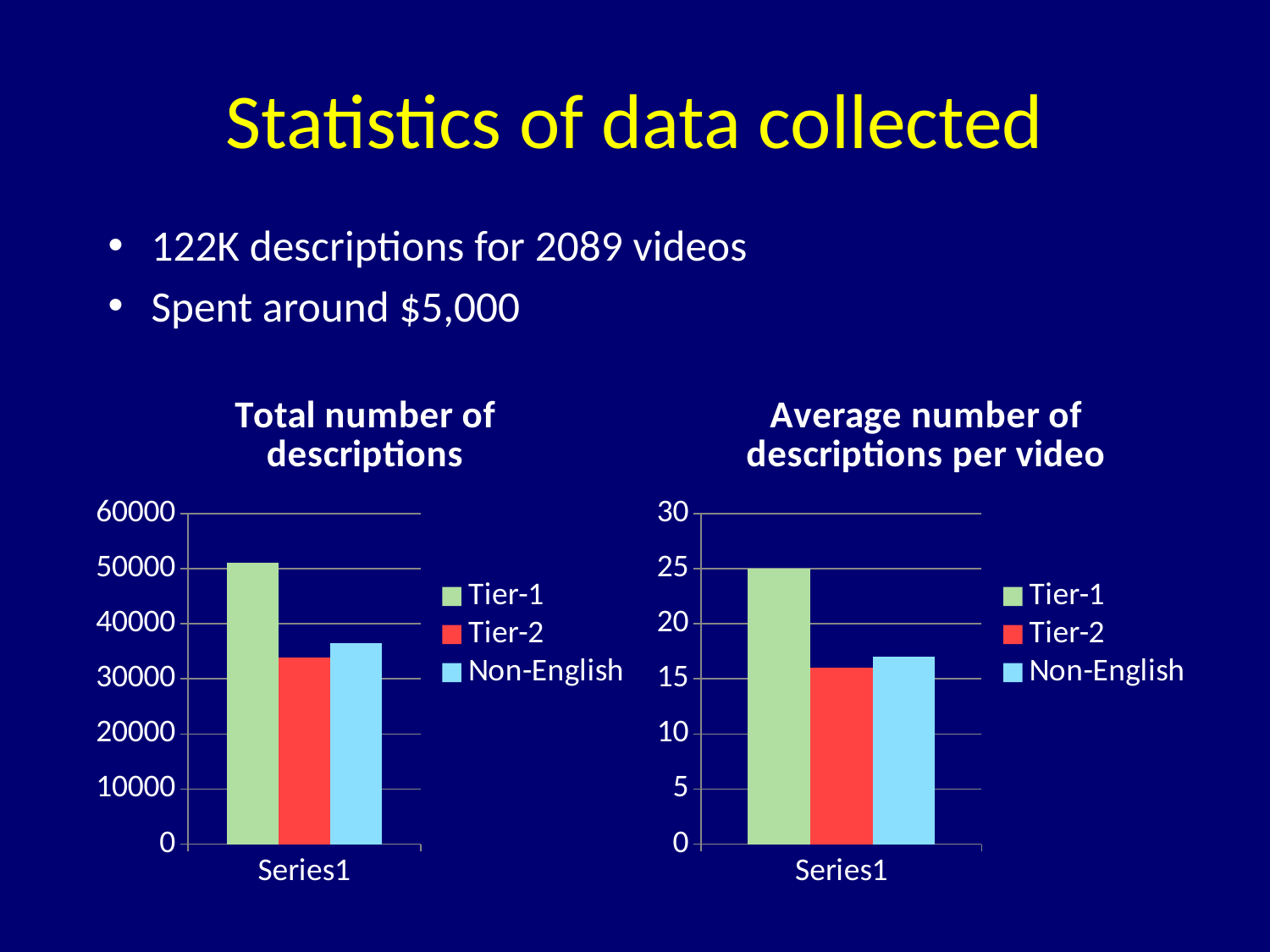
How many series does the legend of the 'Total number of descriptions' chart list? 3 In the 'Total number of descriptions' chart, is the value for Non-English greater or less than 40000? less In the 'Total number of descriptions' chart, which series has the highest value? Tier-1 In the 'Total number of descriptions' chart, is the value for Tier-2 greater or less than 30000? greater In the 'Average number of descriptions per video' chart, what is the value for Tier-1? 25 What kind of chart is the 'Average number of descriptions per video' chart? bar chart In the 'Average number of descriptions per video' chart, is the value for Tier-2 greater or less than 20? less In the 'Total number of descriptions' chart, which is larger, Tier-2 or Non-English? Non-English In the 'Average number of descriptions per video' chart, which series has the highest value? Tier-1 What colour is the Tier-2 bar in the 'Average number of descriptions per video' chart? red